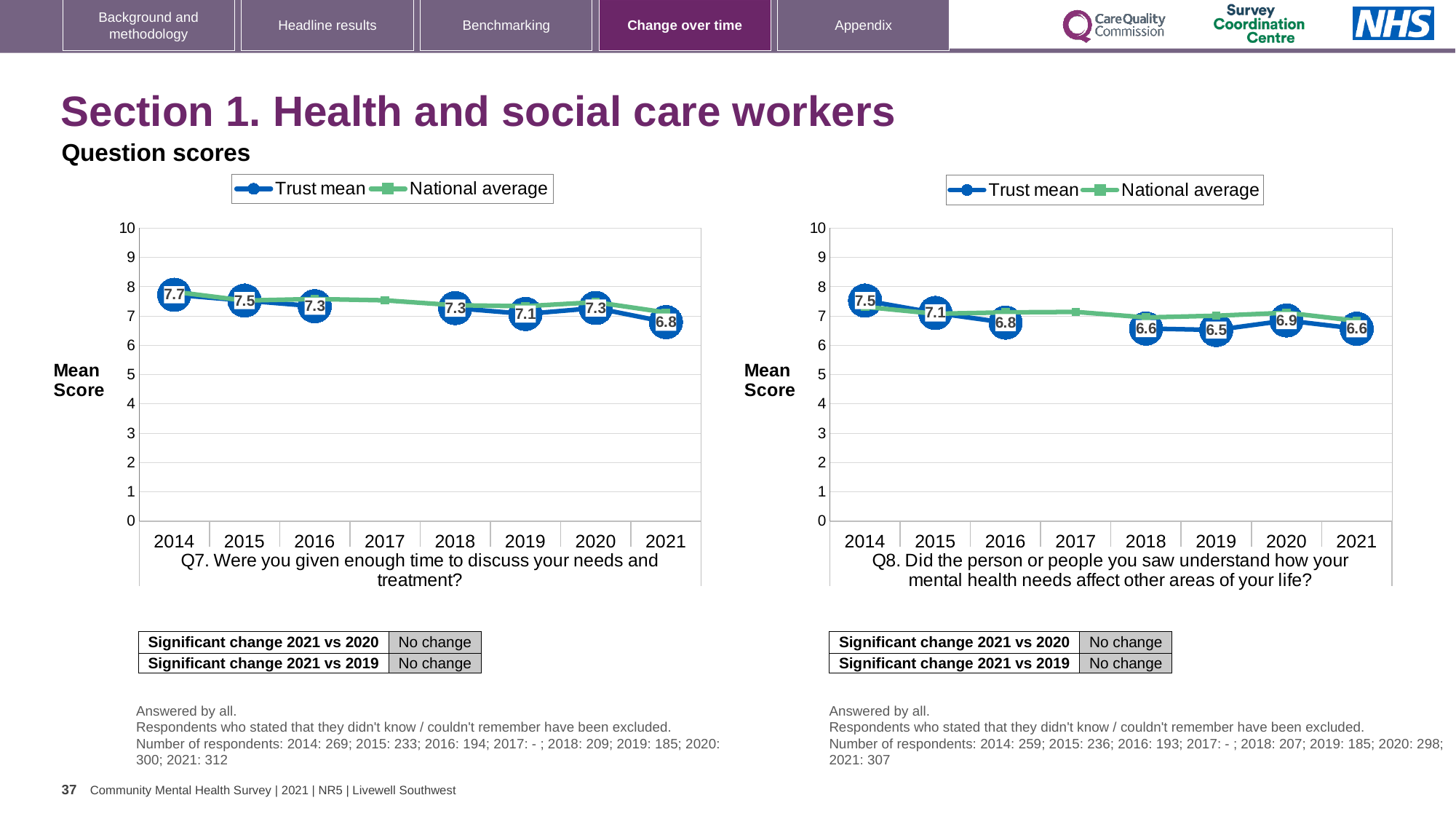
How many series does the legend of the Q8 chart (right) list? 2 How many years are shown on the x axis of the Q7 chart (left)? 8 On the Q7 chart (left), what is the Trust mean for 2014? 7.7 On the Q8 chart (right), is the National average for 2014 greater or less than 5? greater On the Q8 chart (right), what is the Trust mean for 2020? 6.9 On the Q7 chart (left), what is the difference between the Trust mean in 2014 and in 2021? 0.9 On the Q8 chart (right), what is the Trust mean for 2019? 6.5 On the Q7 chart (left), what is the Trust mean for 2021? 6.8 What kind of chart is the Q7 chart (left)? Line chart On the Q8 chart (right), which is larger: the Trust mean for 2015 or for 2018? 2015 On the Q8 chart (right), which year has the lowest Trust mean? 2019 On the Q7 chart (left), which year has the highest Trust mean? 2014